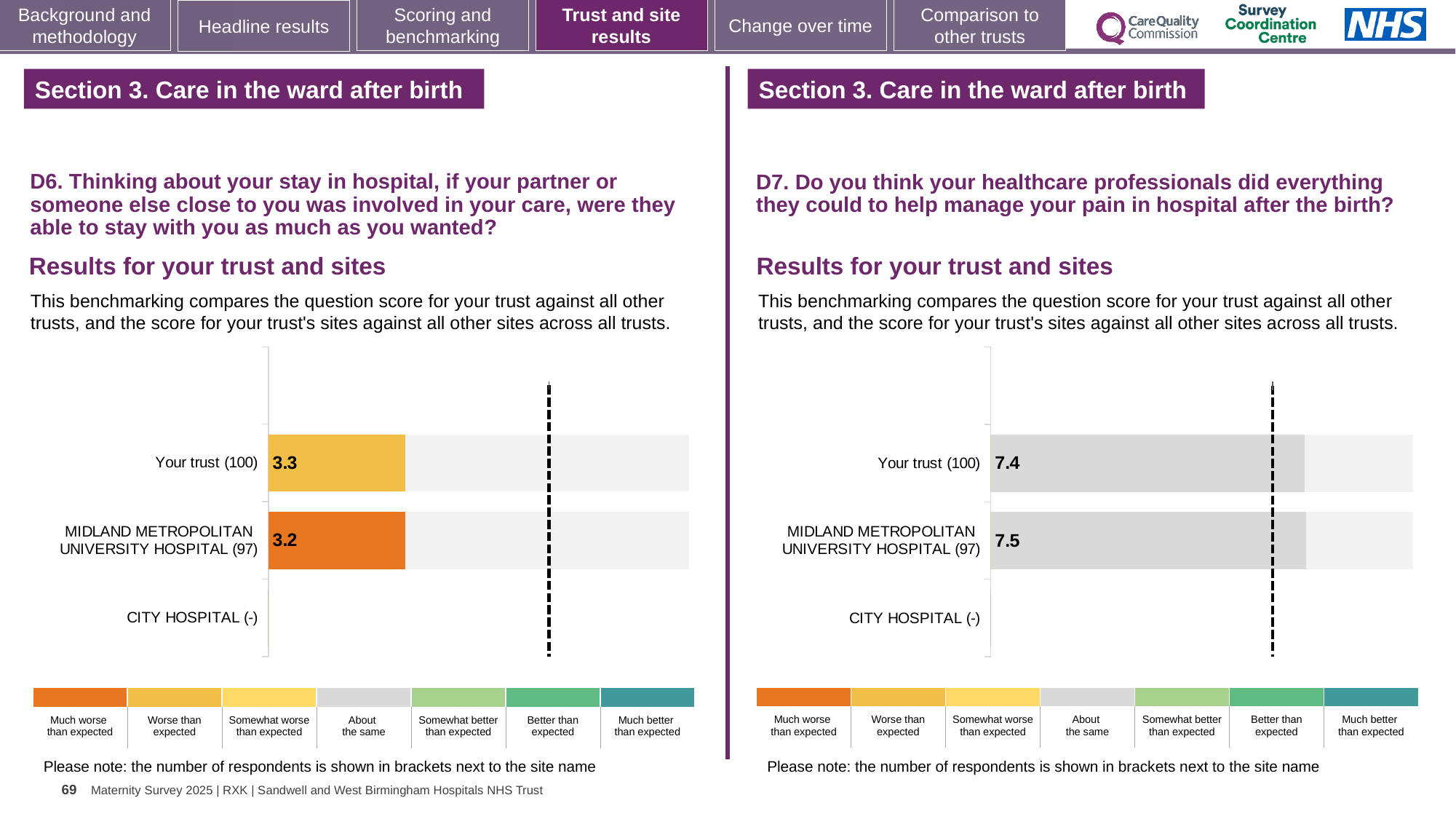
In the D6 chart on the left, what is the score for MIDLAND METROPOLITAN UNIVERSITY HOSPITAL (97)? 3.2 In the D6 chart on the left, what is the score for Your trust (100)? 3.3 In the D6 chart on the left, which has the higher score: Your trust or MIDLAND METROPOLITAN UNIVERSITY HOSPITAL? Your trust In the D7 chart on the right, which has the higher score: Your trust or MIDLAND METROPOLITAN UNIVERSITY HOSPITAL? MIDLAND METROPOLITAN UNIVERSITY HOSPITAL In the D7 chart on the right, what is the score for Your trust (100)? 7.4 How many site/trust rows are listed in the D7 chart on the right? 3 In the D7 chart on the right, what is the difference between the score for MIDLAND METROPOLITAN UNIVERSITY HOSPITAL and the score for Your trust? 0.1 In the D7 chart on the right, which benchmarking category does the colour of the Your trust bar correspond to? About the same In the D6 chart on the left, which benchmarking category does the colour of the MIDLAND METROPOLITAN UNIVERSITY HOSPITAL bar correspond to? Much worse than expected In the D7 chart on the right, what is the score for MIDLAND METROPOLITAN UNIVERSITY HOSPITAL (97)? 7.5 In the D6 chart on the left, what is the difference between the score for Your trust and the score for MIDLAND METROPOLITAN UNIVERSITY HOSPITAL? 0.1 What kind of chart is used for the D6 results on the left? Bar chart